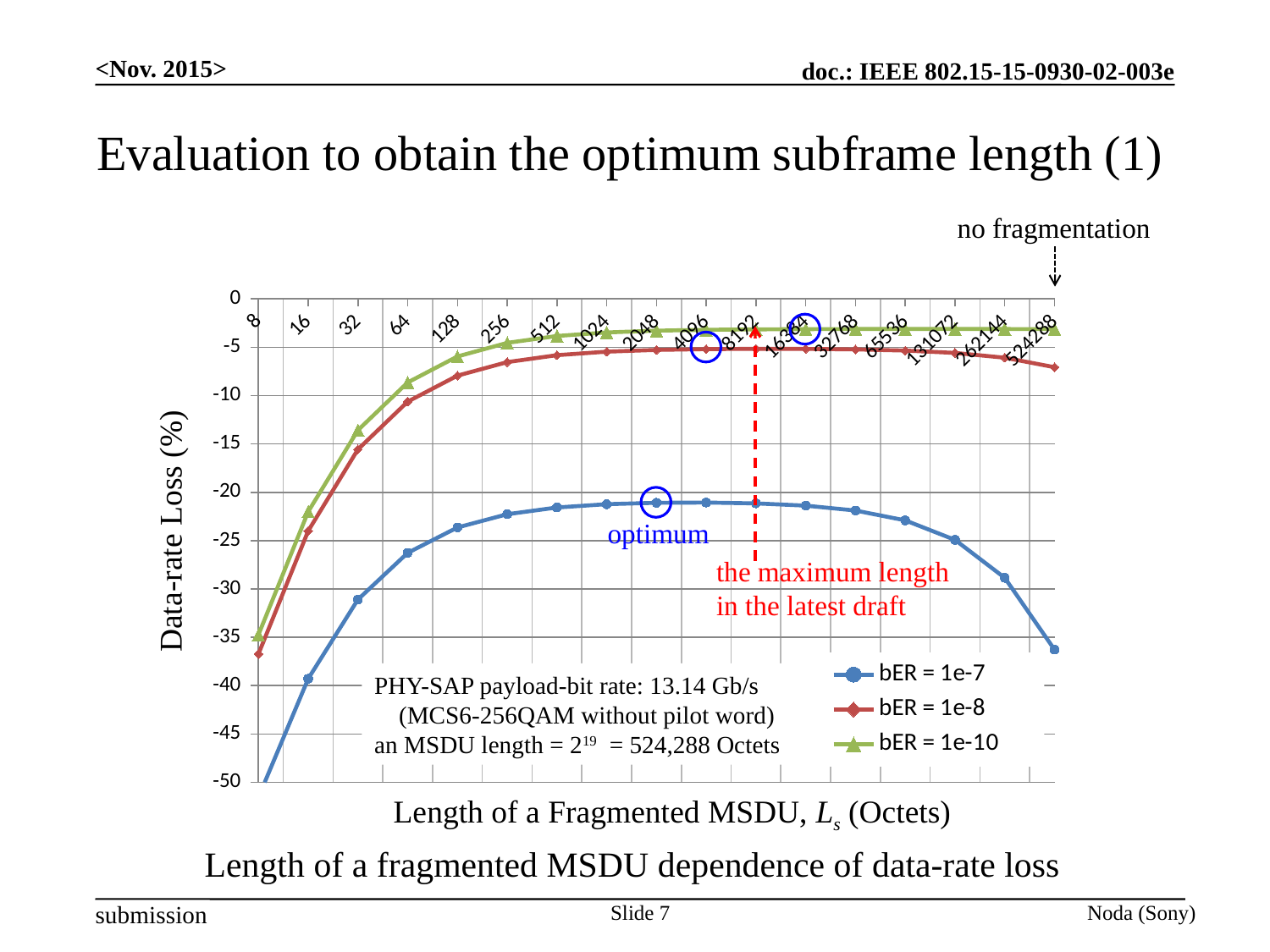
What is the title of the y axis? Data-rate Loss (%) Do the values for bER = 1e-7 rise or fall as the length increases from 8 to 4096 octets? rise What kind of chart is shown on the slide? line chart How many categories are shown along the x axis? 17 Is the value for bER = 1e-10 at 16 octets greater or less than -25? greater Is the value for bER = 1e-7 at 1024 octets greater or less than -25? greater At a fragmented MSDU length of 4096 octets, which series has the larger value, bER = 1e-10 or bER = 1e-7? bER = 1e-10 Is the value for bER = 1e-7 at 16 octets greater or less than -35? less How many series does the legend list? 3 Do the values for bER = 1e-7 rise or fall as the length increases from 16384 to 524288 octets? fall Which series has the highest (least negative) data-rate loss values across the chart? bER = 1e-10 Which series has the lowest (most negative) data-rate loss values across the chart? bER = 1e-7